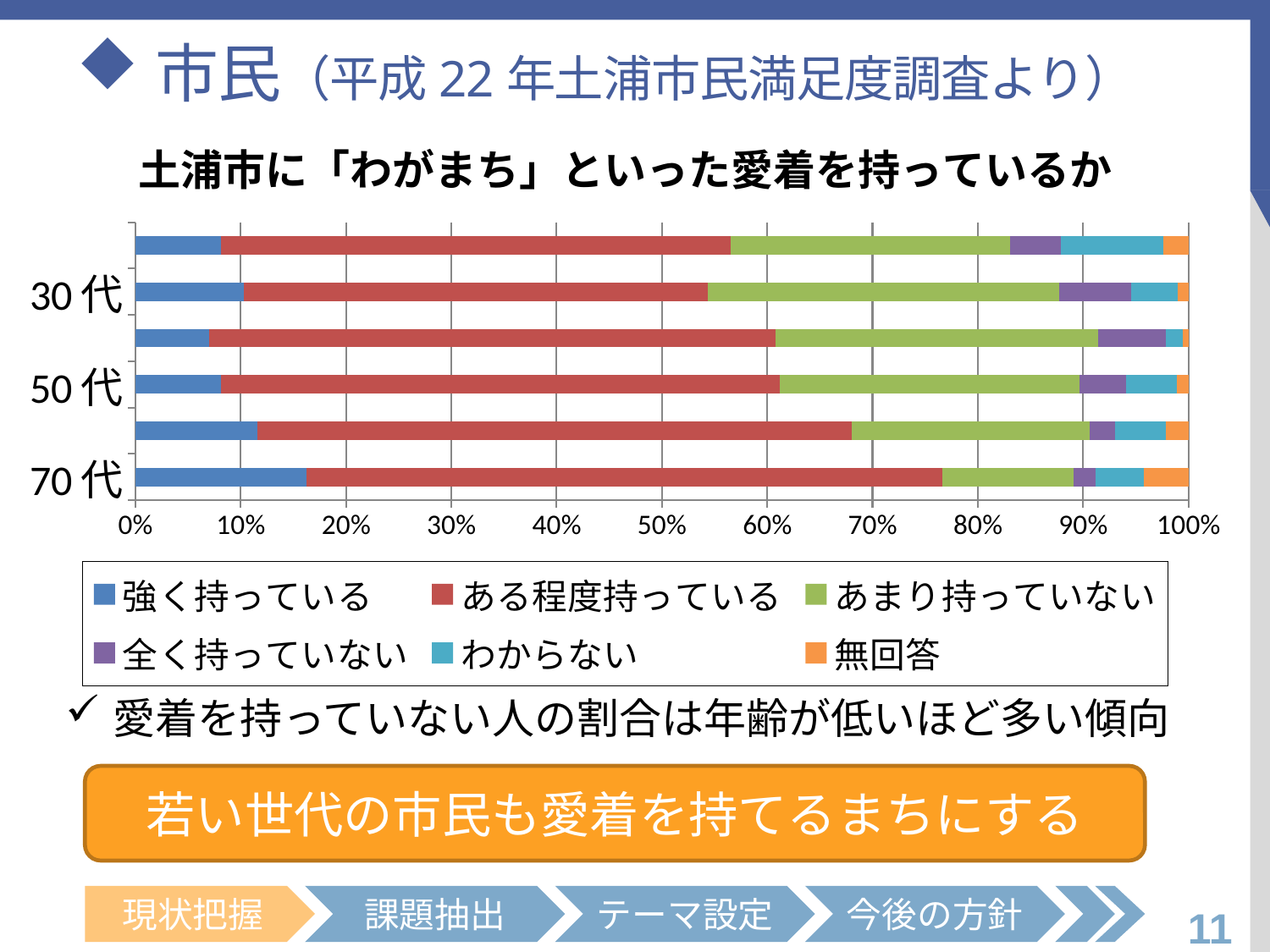
Which has the larger 強く持っている value, 50代 or 70代? 70代 Which has the larger 強く持っている value, 30代 or 70代? 70代 Which has the larger ある程度持っている segment, 30代 or 70代? 70代 Is the value for 強く持っている in the 70代 bar greater or less than 20%? less What kind of chart is shown on the slide? Stacked bar chart Which colour represents 無回答 in the legend? Orange What is the title of the chart? 土浦市に「わがまち」といった愛着を持っているか Which labelled age group has the longest 強く持っている segment? 70代 How many bars (age groups) are plotted in the chart? 6 How many series does the legend list? 6 Is the value for 強く持っている in the 70代 bar greater or less than 10%? greater Is the value for 強く持っている in the 50代 bar greater or less than 20%? less